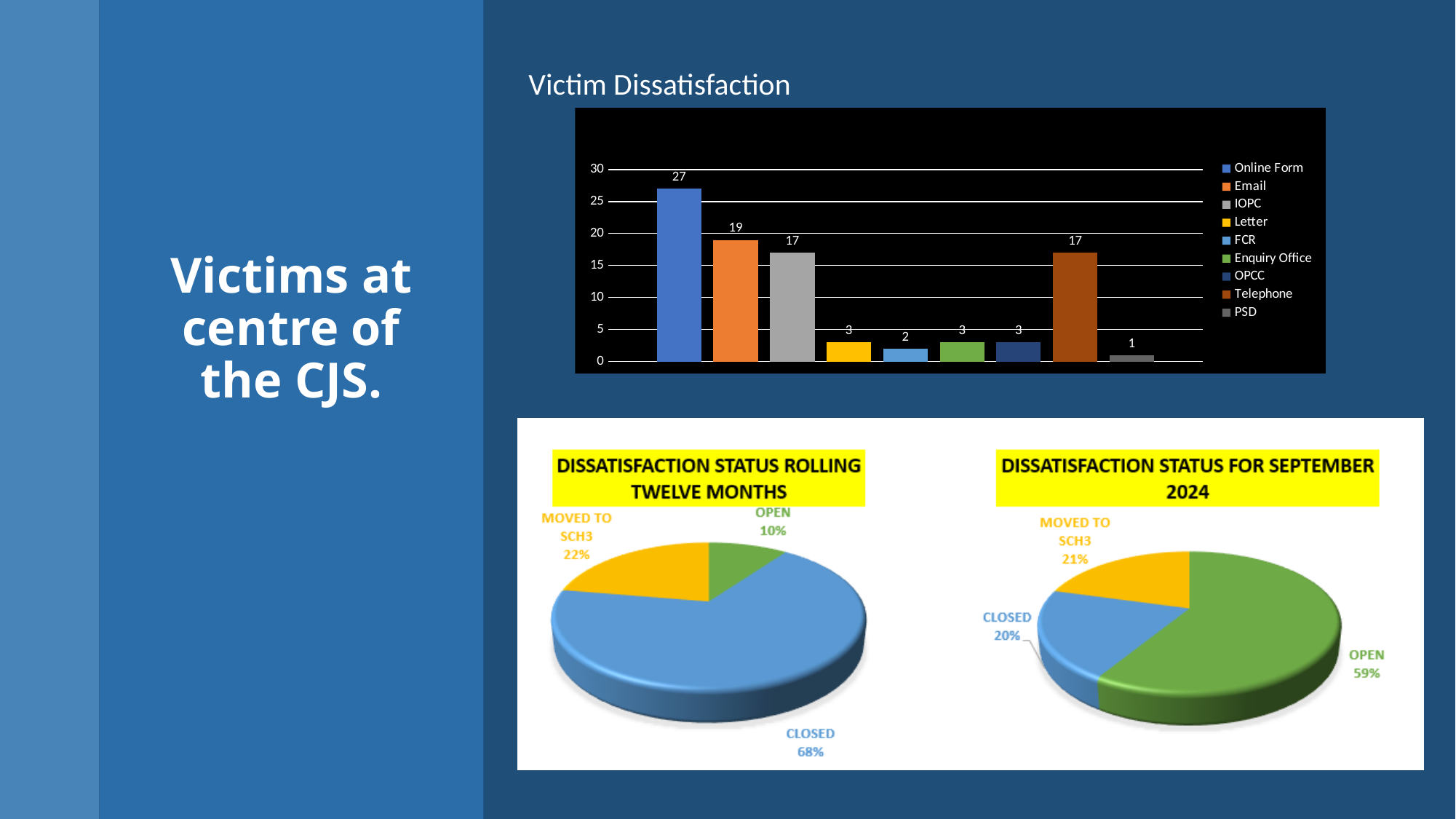
In the Victim Dissatisfaction bar chart, which category has the highest value? Online Form What kind of chart is the Victim Dissatisfaction chart? Bar chart In the Dissatisfaction Status Rolling Twelve Months pie chart, what share is Open? 10% In the Victim Dissatisfaction bar chart, which is larger, the value for Email or the value for IOPC? Email How many entries does the legend of the Victim Dissatisfaction bar chart list? 9 In the Victim Dissatisfaction bar chart, which category has the lowest value? PSD In the Dissatisfaction Status for September 2024 pie chart, what share is Moved to SCH3? 21% In the Victim Dissatisfaction bar chart, what is the value for Telephone? 17 In the Dissatisfaction Status for September 2024 pie chart, which slice is the largest? Open In the Victim Dissatisfaction bar chart, what is the value for Online Form? 27 In the Victim Dissatisfaction bar chart, what is the difference between the values for Online Form and Email? 8 In the Dissatisfaction Status Rolling Twelve Months pie chart, what share is Closed? 68%